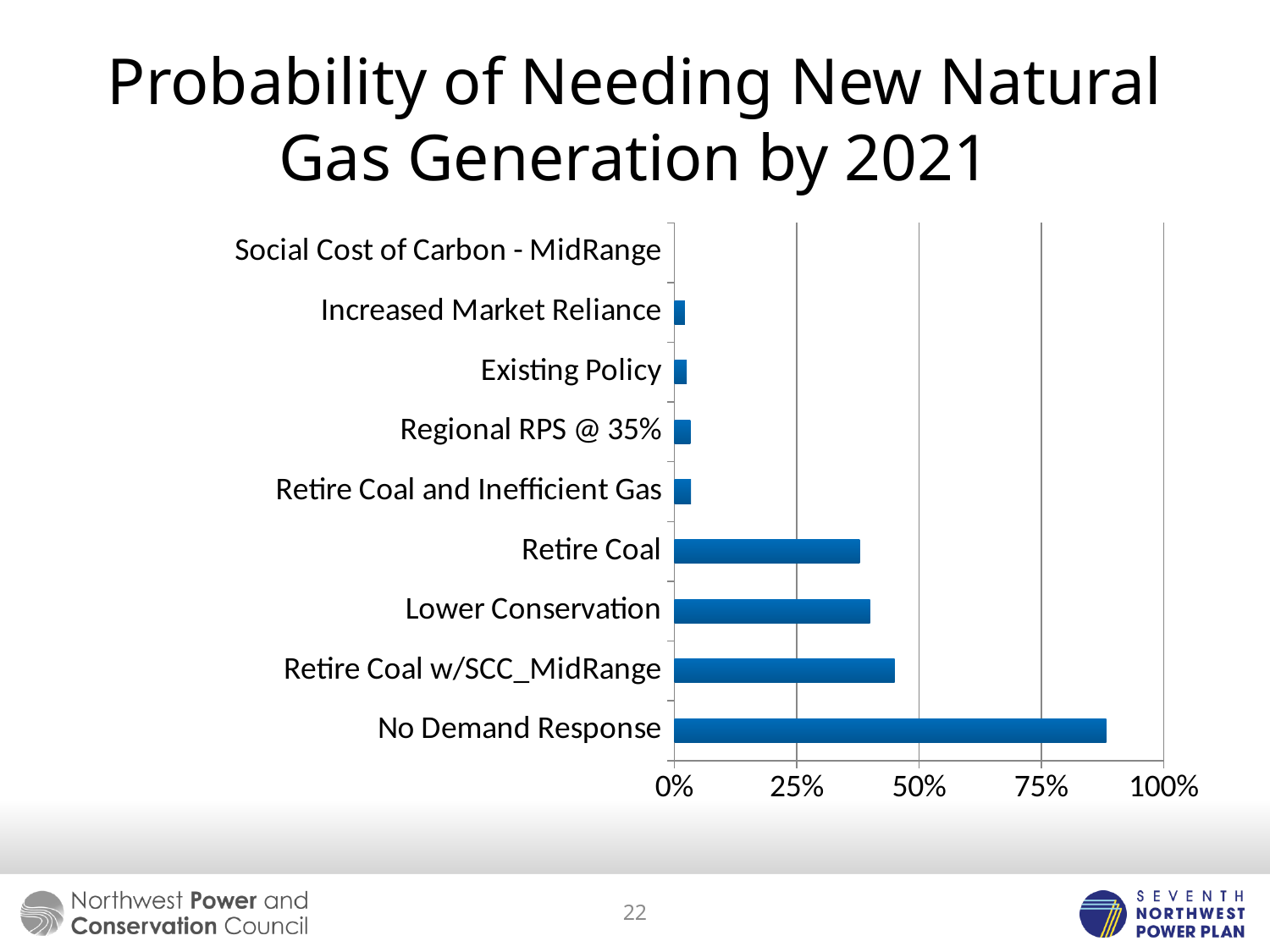
Is the value for Retire Coal w/SCC_MidRange greater or less than 25%? greater Is the value for Retire Coal greater or less than 50%? less How many categories are plotted in the chart? 9 Which category has the highest probability of needing new natural gas generation by 2021? No Demand Response What kind of chart is shown on the slide? bar chart Which is larger, the value for Retire Coal w/SCC_MidRange or the value for Increased Market Reliance? Retire Coal w/SCC_MidRange Is the value for Existing Policy greater or less than 25%? less Which is larger, the value for No Demand Response or the value for Retire Coal? No Demand Response Which category has the lowest probability of needing new natural gas generation by 2021? Social Cost of Carbon - MidRange What is the title of the chart on the slide? Probability of Needing New Natural Gas Generation by 2021